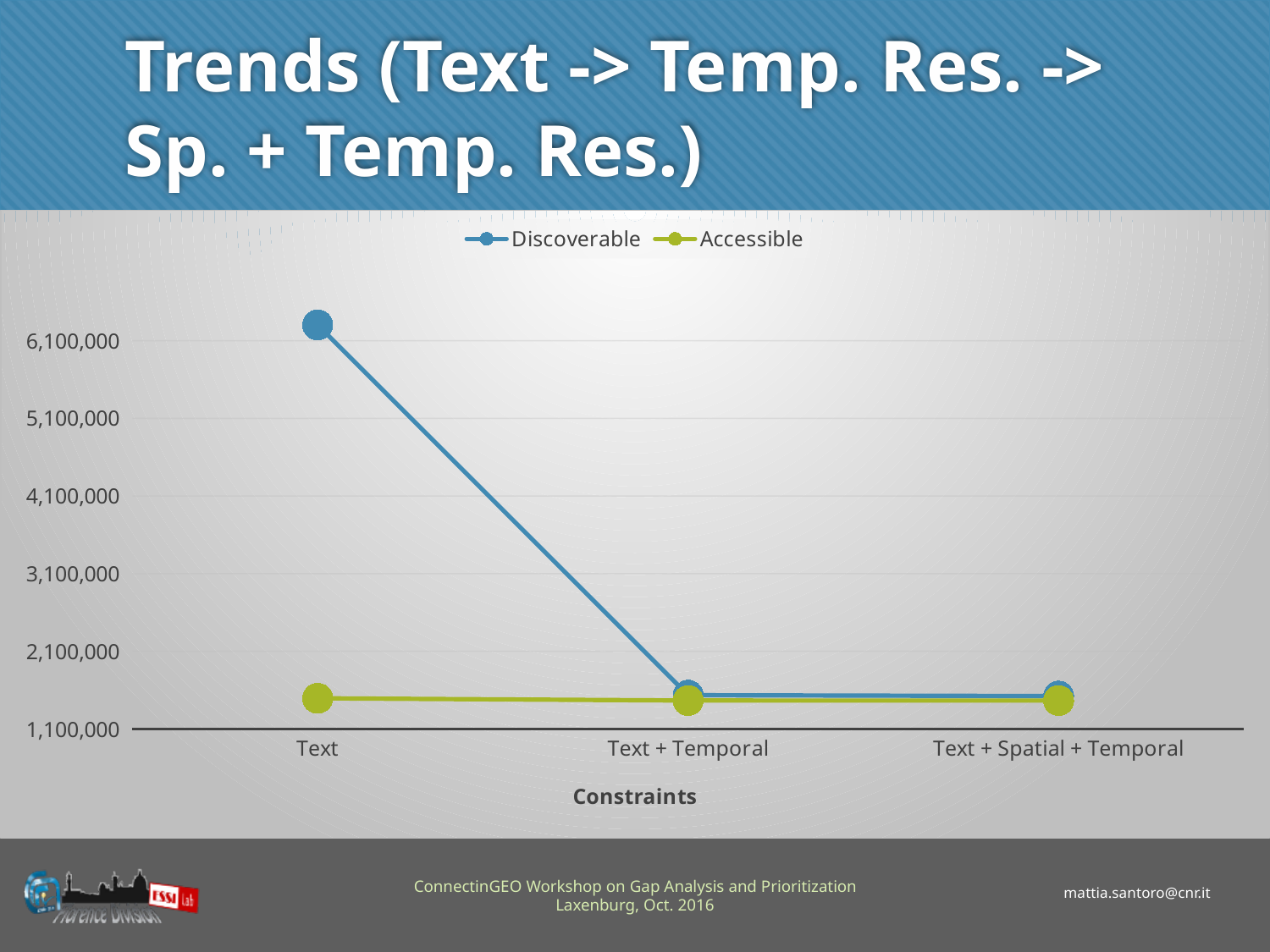
Is the Discoverable value for Text + Spatial + Temporal greater or less than 3,100,000? less How many series does the legend list? 2 How many categories are shown on the x axis? 3 Is the Discoverable value for Text greater or less than 6,100,000? greater For which constraint is the Discoverable value highest? Text Is the Discoverable value for Text + Temporal greater or less than 2,100,000? less Does the Discoverable series rise or fall from Text to Text + Temporal? Fall Which series is drawn in green? Accessible For the Text constraint, which series has the larger value, Discoverable or Accessible? Discoverable What kind of chart is shown on the slide? Line chart What is the title of the x axis? Constraints